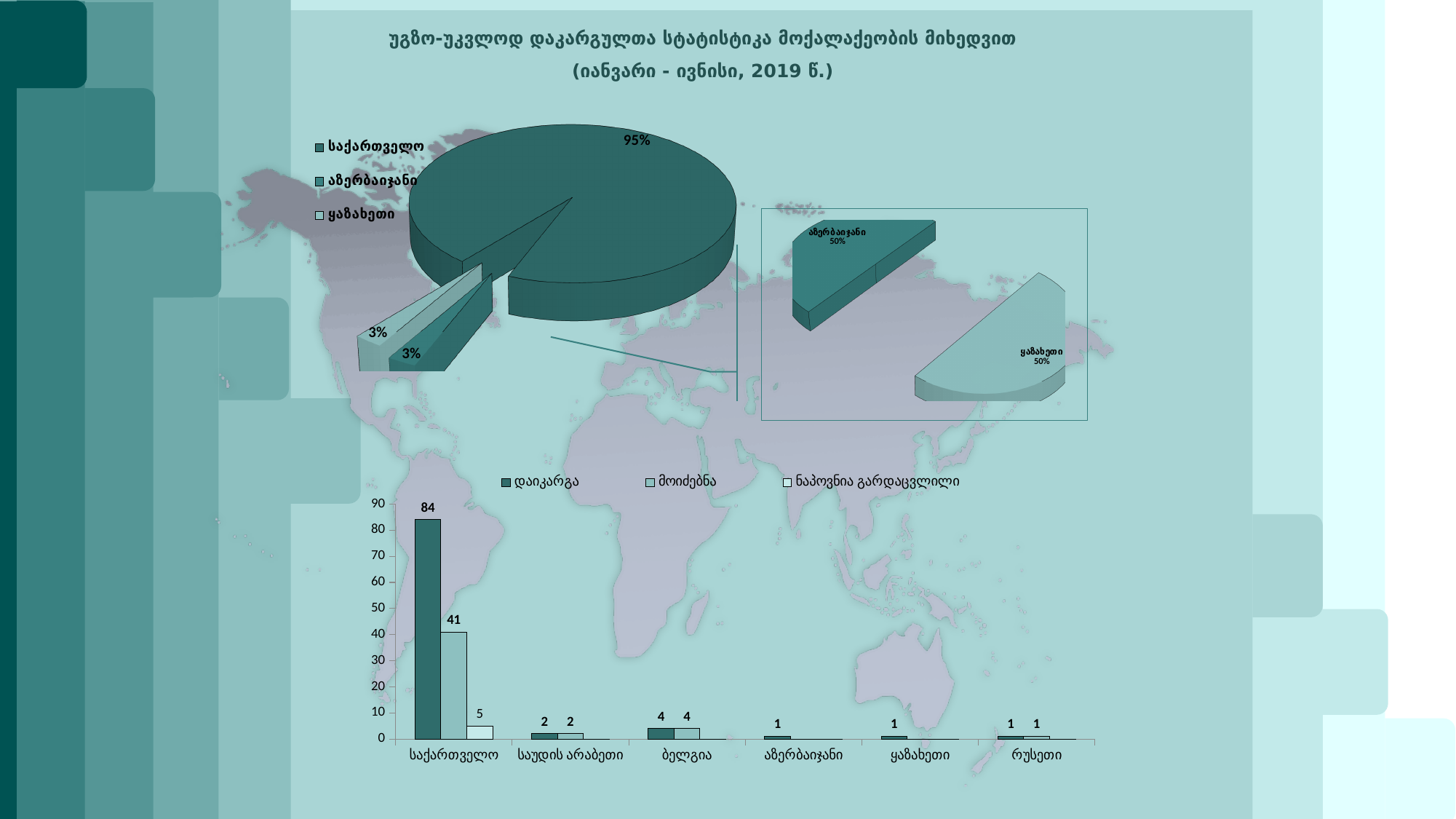
What kind of chart is the chart at the bottom of the slide? bar chart In the pie chart at the top of the slide, what share does საქართველო have? 95% In the pie chart at the top of the slide, which category has the largest slice? საქართველო In the bar chart at the bottom of the slide, what is the value of მოიძებნა for საქართველო? 41 How many categories are shown on the x axis of the bar chart at the bottom of the slide? 6 In the bar chart at the bottom of the slide, what is the value of ნაპოვნია გარდაცვლილი for საქართველო? 5 In the bar chart at the bottom of the slide, is the დაიკარგა value for ბელგია larger or smaller than the დაიკარგა value for საუდის არაბეთი? larger In the bar chart at the bottom of the slide, which category has the highest დაიკარგა value? საქართველო In the pie chart at the top of the slide, what share does აზერბაიჯანი have? 3% How many categories does the legend of the pie chart at the top of the slide list? 3 In the bar chart at the bottom of the slide, what is the value of დაიკარგა for საქართველო? 84 In the bar chart at the bottom of the slide, what is the difference between დაიკარგა and მოიძებნა for საქართველო? 43